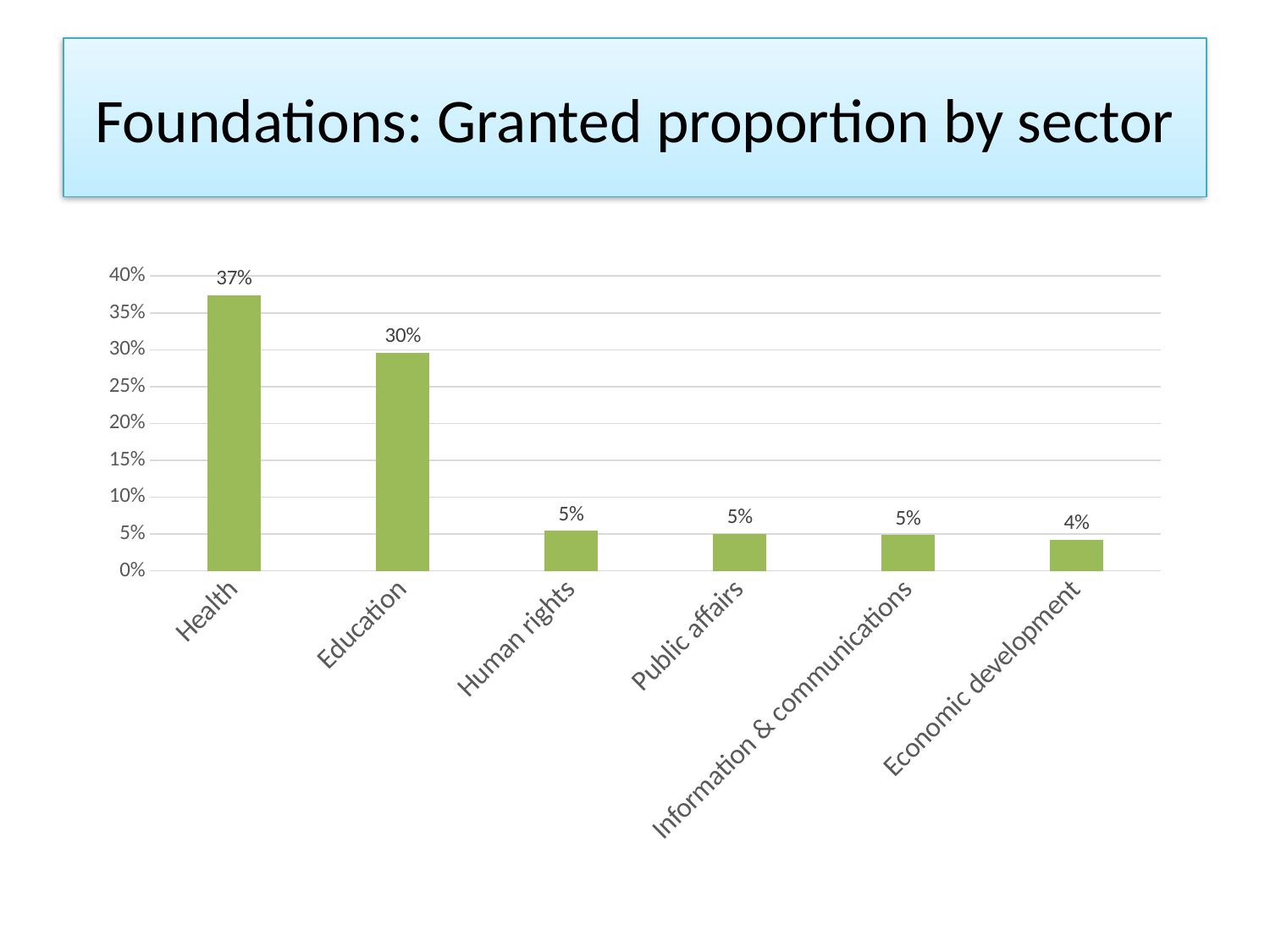
What is the granted proportion for Economic development? 4% What is the difference between the granted proportions for Health and Education? 7% Is the value for Education greater or less than 25%? greater Which sector has the highest granted proportion? Health What is the granted proportion for Health? 37% Which has a larger granted proportion, Education or Human rights? Education How many sectors are shown in the chart? 6 What kind of chart is shown on the slide? Bar chart What is the granted proportion for Information & communications? 5% Which sector has the lowest granted proportion? Economic development What is the title of the slide? Foundations: Granted proportion by sector What is the granted proportion for Education? 30%